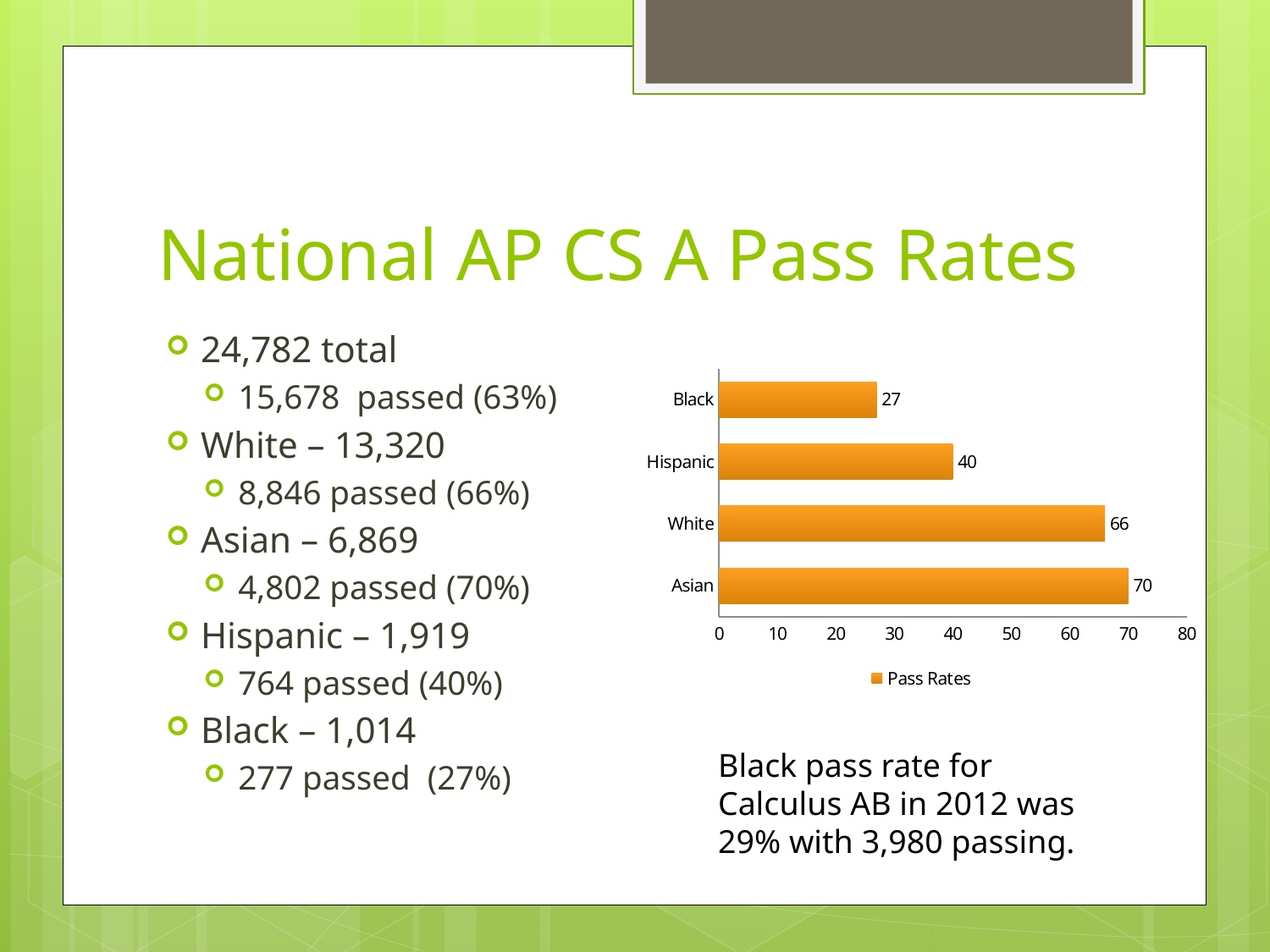
How many categories are shown in the chart? 4 Which has a higher pass rate in the chart, Hispanic or White? White What is the difference between the Asian and Black pass rates in the chart? 43 What is the pass rate value shown for Hispanic in the chart? 40 What is the pass rate value shown for White in the chart? 66 Which category has the highest pass rate in the chart? Asian What is the difference between the White and Hispanic pass rates in the chart? 26 What is the pass rate value shown for Black in the chart? 27 What is the pass rate value shown for Asian in the chart? 70 Which category has the lowest pass rate in the chart? Black What type of chart is shown on the slide? Bar chart What series name does the chart legend list? Pass Rates